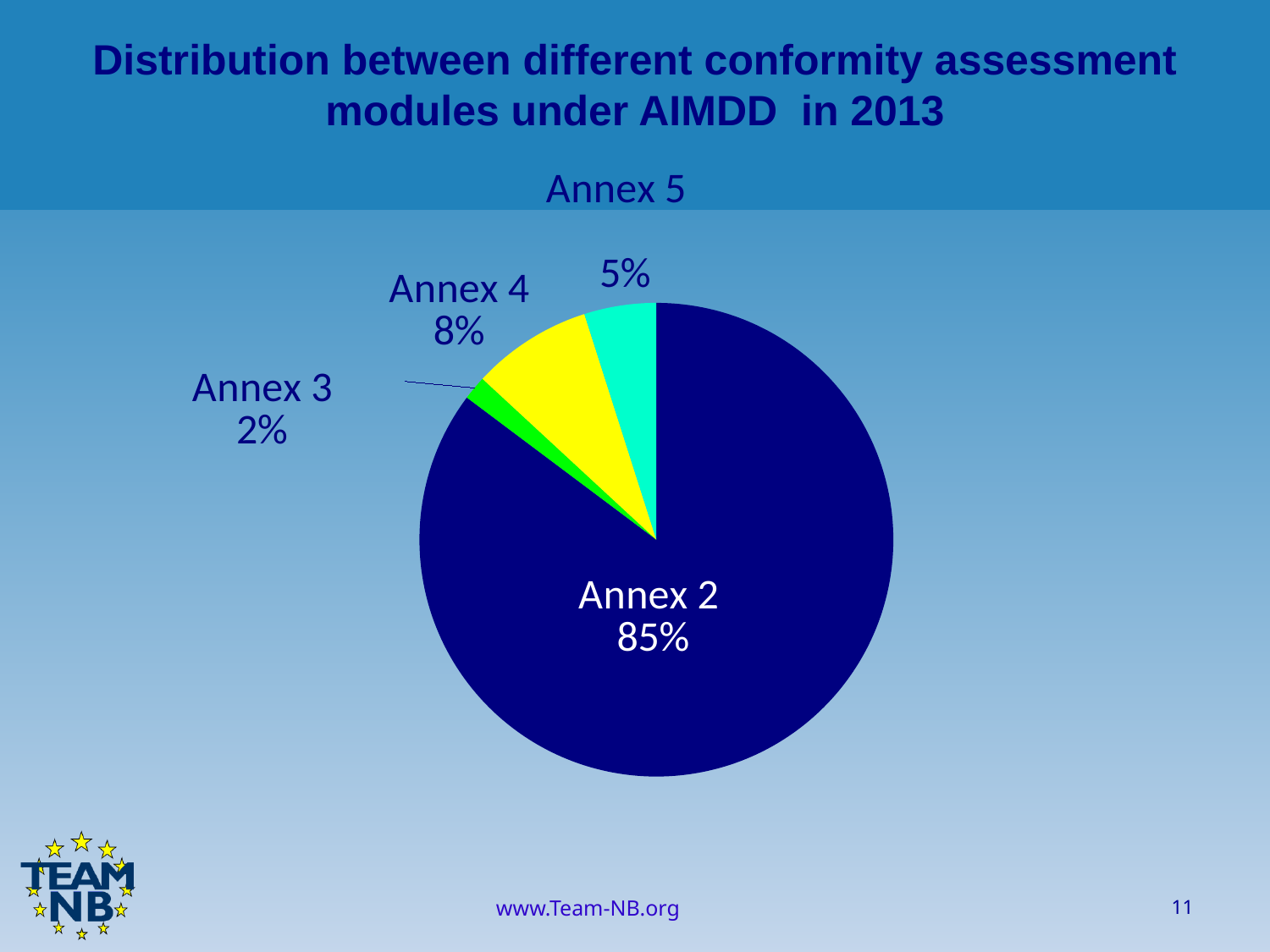
What is the value shown for Annex 5? 5% Which is larger, the share for Annex 4 or the share for Annex 5? Annex 4 How many slices does the pie chart have? 4 Which annex has the smallest share of the pie? Annex 3 What is the value shown for Annex 3? 2% What colour is the Annex 4 slice? yellow What is the value shown for Annex 4? 8% What is the difference in percentage points between Annex 2 and Annex 4? 77% What type of chart is shown on the slide? pie chart What is the difference in percentage points between Annex 4 and Annex 5? 3% Which annex has the largest share of the pie? Annex 2 What share of the pie does Annex 2 represent? 85%